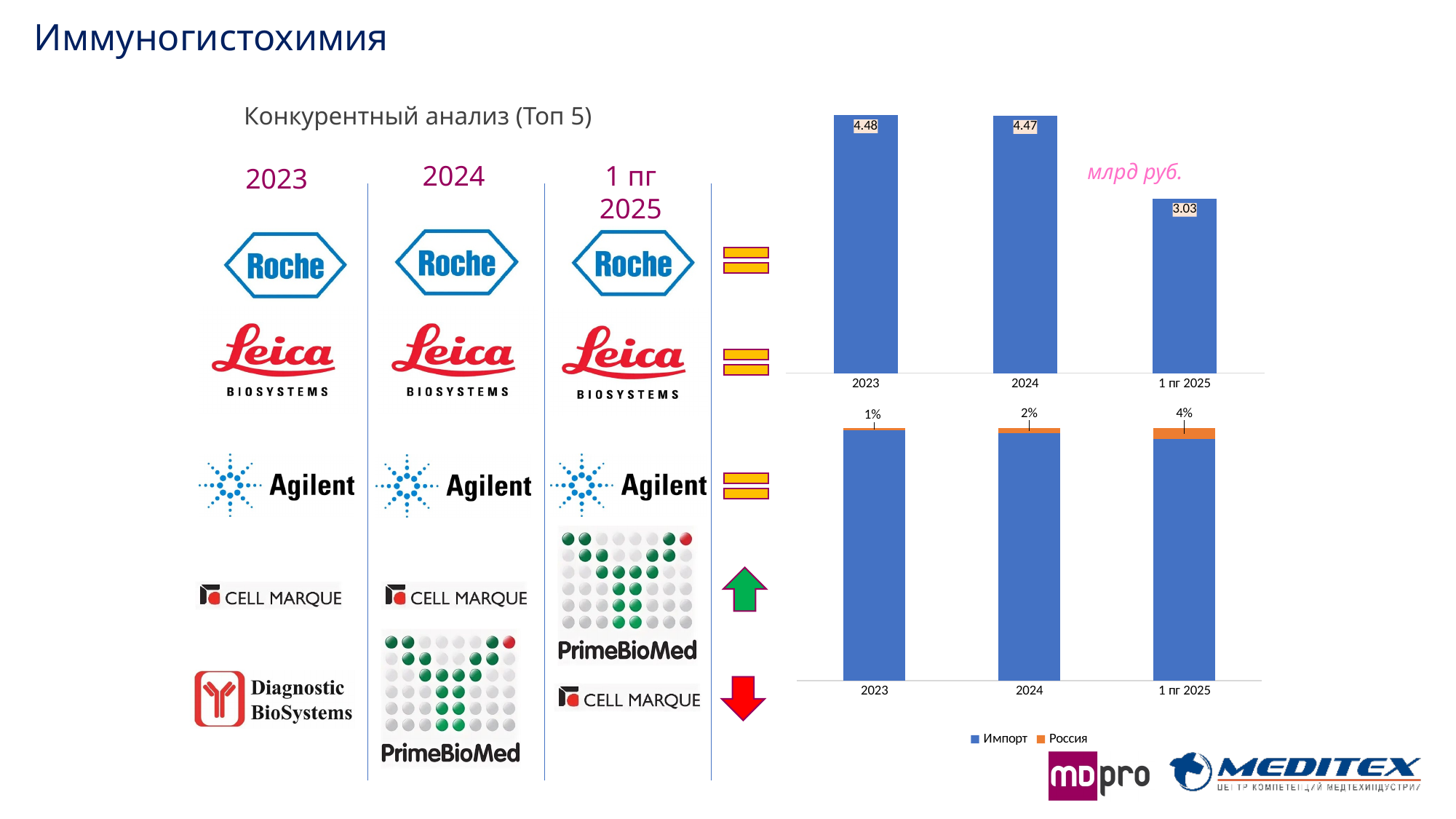
In the top bar chart on the right, what is the value for 2024? 4.47 In the bottom stacked bar chart on the right, do the percentage labels rise or fall from 2023 to 1 пг 2025? rise In the top bar chart on the right, how many bars are plotted? 3 In the bottom stacked bar chart on the right, what percentage label is shown above the 1 пг 2025 bar? 4% In the top bar chart on the right, what is the value for 1 пг 2025? 3.03 In the bottom stacked bar chart on the right, which series is shown in orange? Россия In the bottom stacked bar chart on the right, how many series does the legend list? 2 In the top bar chart on the right, what is the value for 2023? 4.48 In the bottom stacked bar chart on the right, what percentage label is shown above the 2023 bar? 1% In the top bar chart on the right, which category has the lowest value? 1 пг 2025 In the top bar chart on the right, what is the difference between the 2023 value and the 1 пг 2025 value? 1.45 In the top bar chart on the right, what unit is indicated next to the bars? млрд руб.